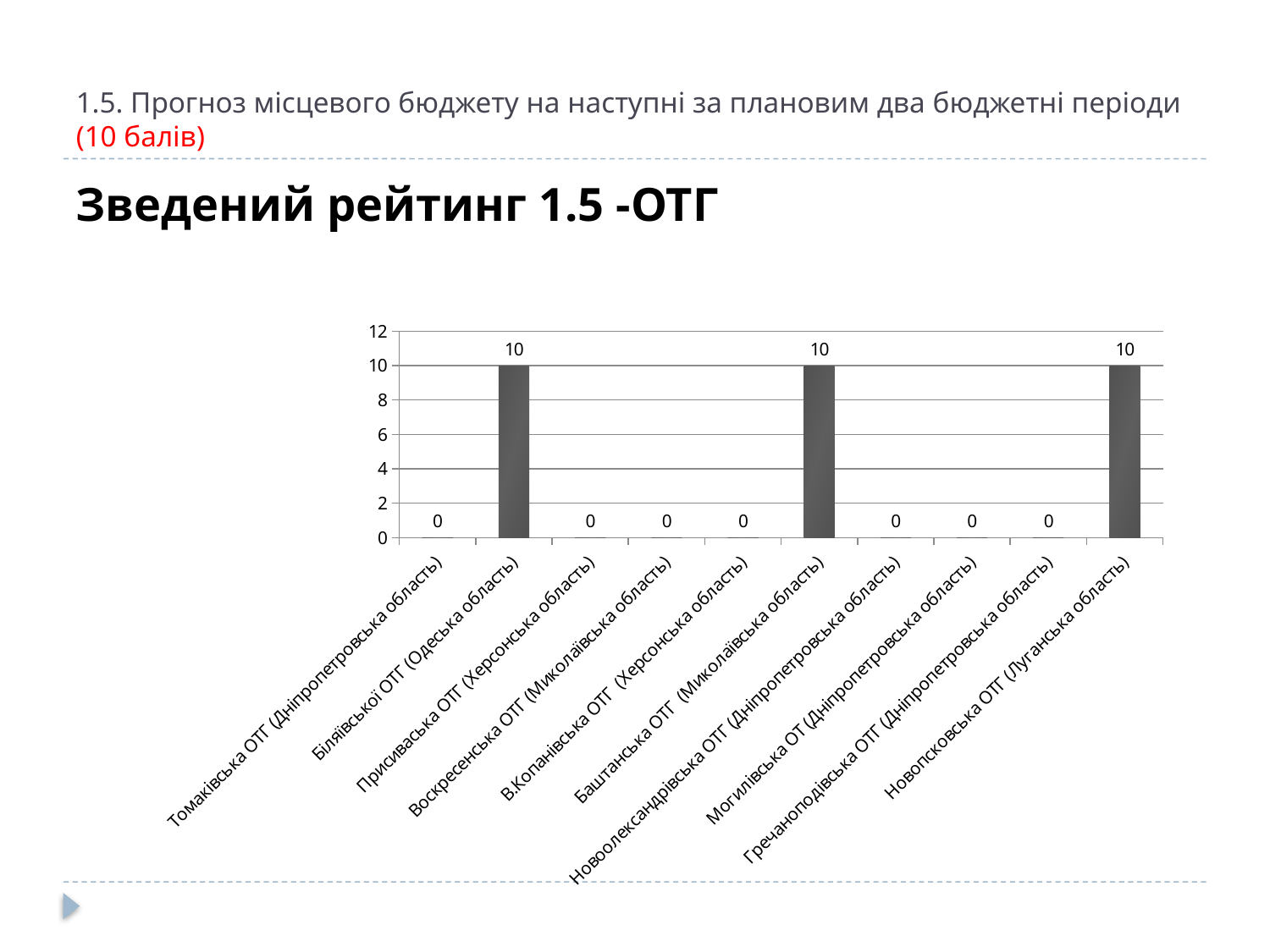
What value is shown for Баштанська ОТГ (Миколаївська область)? 10 What value is shown for Новопсковська ОТГ (Луганська область)? 10 What is the difference between the values for Баштанська ОТГ (Миколаївська область) and Присиваська ОТГ (Херсонська область)? 10 How many categories have a value of 10? 3 Which has the larger value: Новопсковська ОТГ (Луганська область) or Гречаноподівська ОТГ (Дніпропетровська область)? Новопсковська ОТГ (Луганська область) What value is shown for Могилівська ОТ (Дніпропетровська область)? 0 What is the maximum value shown on the vertical axis of the chart? 12 What is the title of the chart on the slide? Зведений рейтинг 1.5 -ОТГ What kind of chart is shown on the slide? bar chart What value is shown for Біляївської ОТГ (Одеська область)? 10 What value is shown for Томаківська ОТГ (Дніпропетровська область)? 0 How many categories are plotted on the x axis of the chart? 10